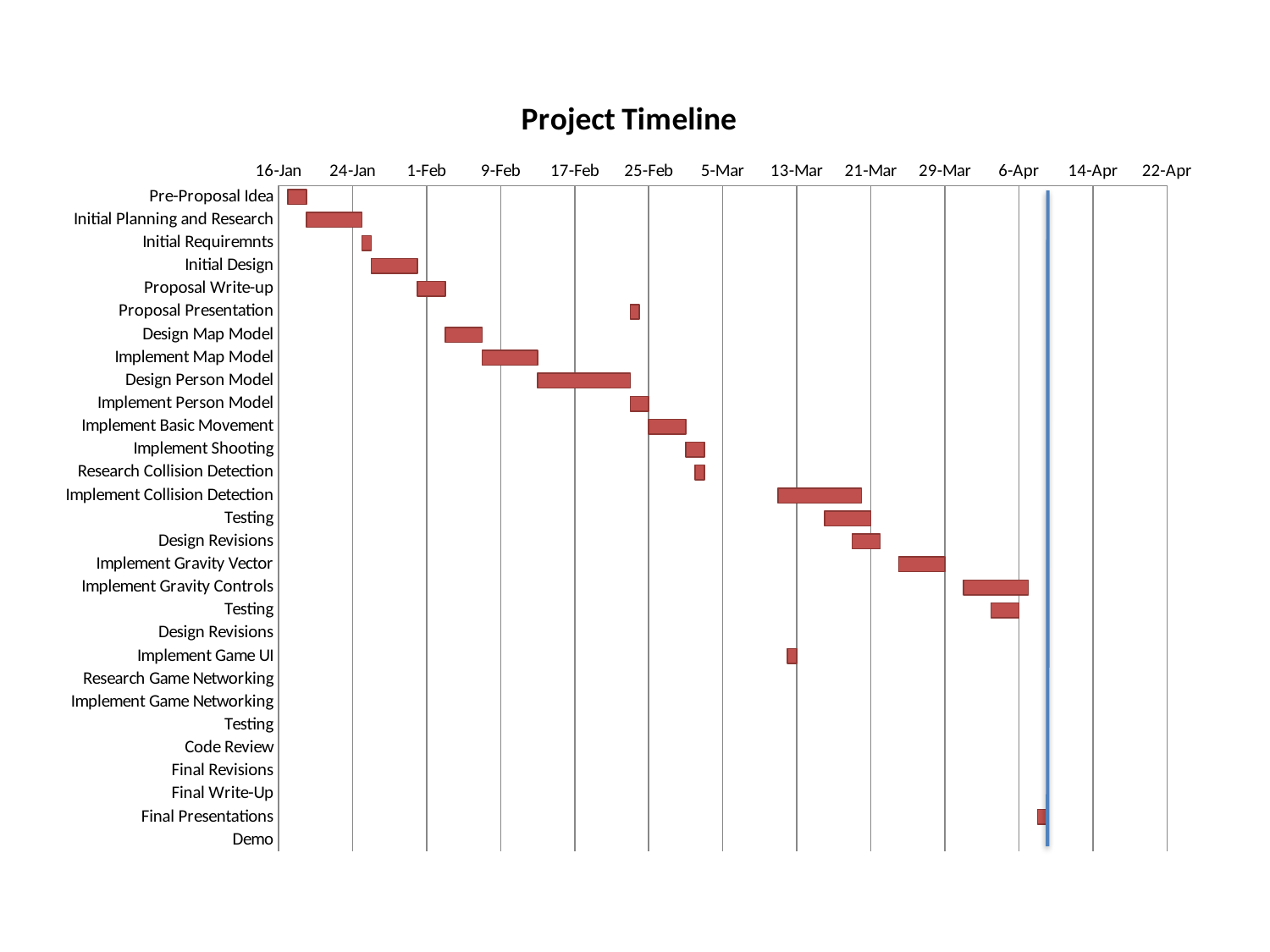
Which task's bar starts earliest on the timeline? Pre-Proposal Idea Which bar is longer, Initial Planning and Research or Initial Requiremnts? Initial Planning and Research Which task's bar is the latest on the timeline? Final Presentations What is the title of the chart? Project Timeline Is there a bar plotted for the Code Review task? No Does the bar for Design Map Model start before or after 1-Feb? after What kind of chart is shown on the slide? Bar chart (Gantt-style horizontal bar chart) Does the bar for Implement Gravity Vector start before or after 21-Mar? after Does the bar for Implement Collision Detection start before or after 13-Mar? before How many tasks are listed on the vertical axis of the chart? 29 Which bar is longer, Design Person Model or Implement Person Model? Design Person Model